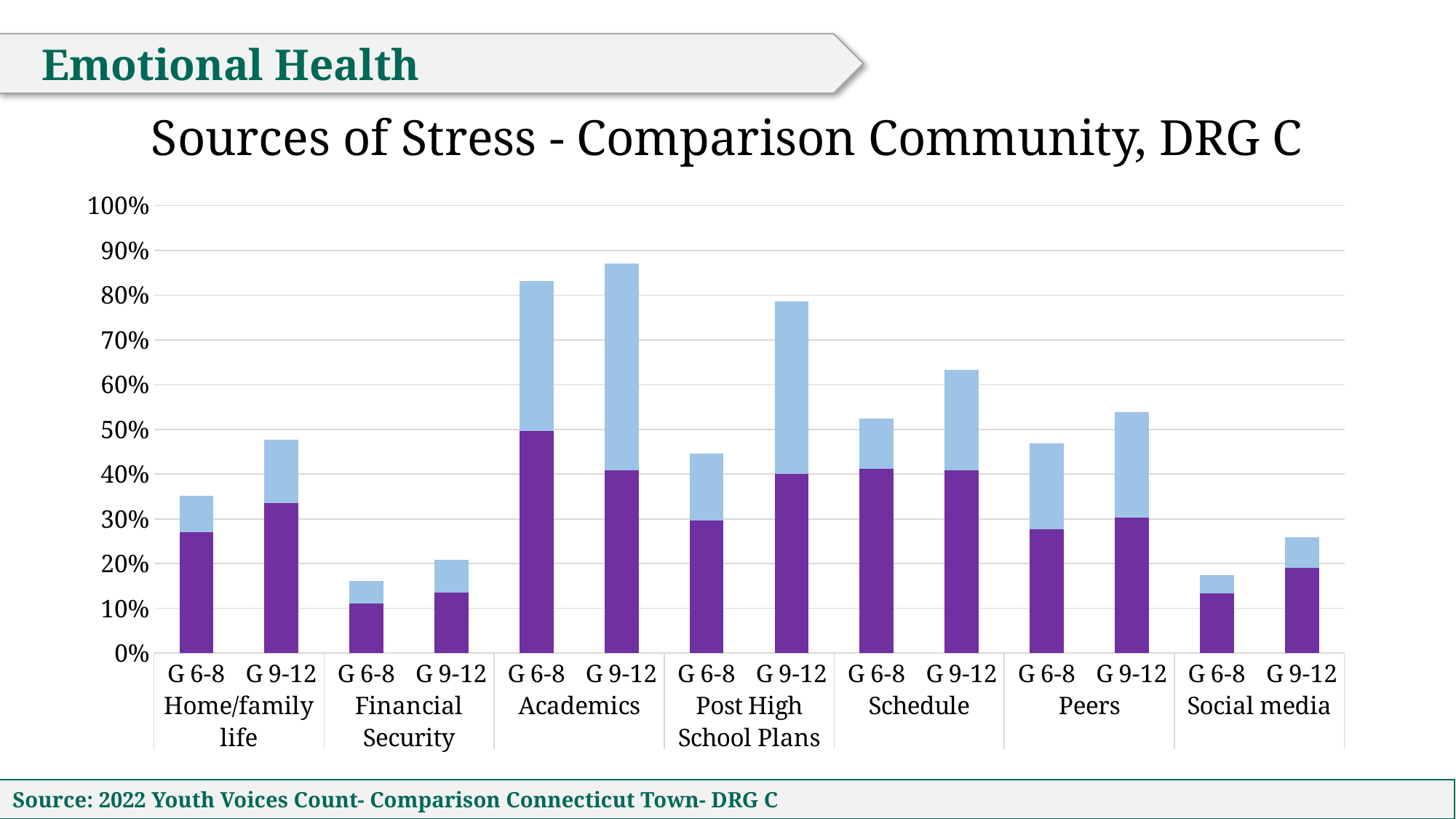
Which G 9-12 bar is taller: Schedule or Peers? Schedule How many sources of stress (categories) are shown along the x axis? 7 Is the total for Home/family life G 6-8 greater or less than 40%? less Which bar is the tallest on the chart? Academics, G 9-12 Is the total for Post High School Plans G 9-12 greater or less than 70%? greater Is the total for Academics G 6-8 greater or less than 80%? greater What is the title of the chart? Sources of Stress - Comparison Community, DRG C How many bars are plotted in total on the chart? 14 Among the G 9-12 bars, which source of stress has the lowest total? Financial Security For Post High School Plans, which bar is taller: G 6-8 or G 9-12? G 9-12 What kind of chart is shown on the slide? Stacked bar chart Is the G 9-12 bar taller than the G 6-8 bar in every source of stress category? Yes